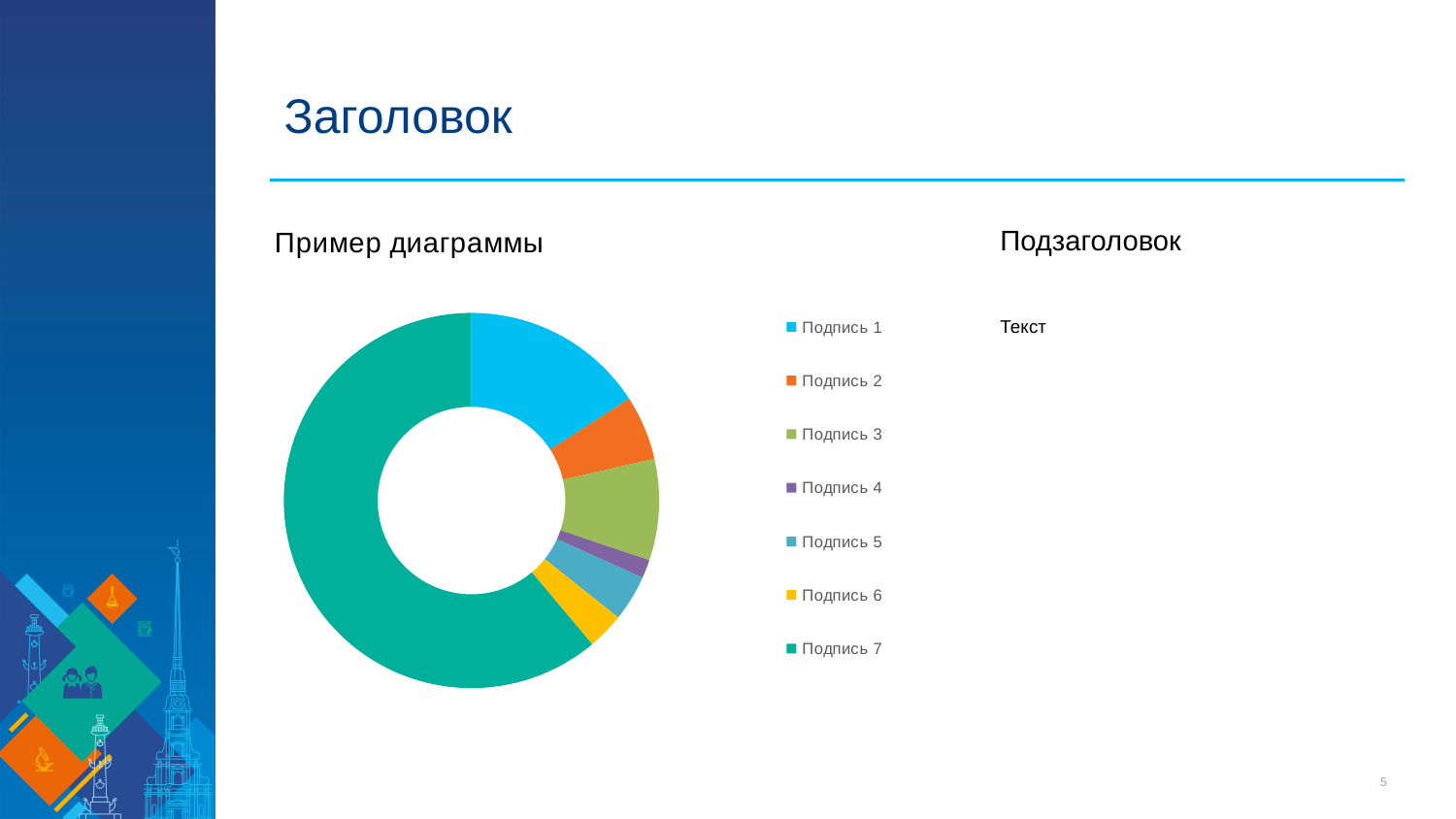
Which category has the smallest slice in the chart? Подпись 4 What colour is the slice for Подпись 6 in the chart? Yellow Which slice is larger, Подпись 7 or Подпись 3? Подпись 7 How many categories does the legend of the chart list? 7 Which slice is larger, Подпись 1 or Подпись 2? Подпись 1 Which category has the largest slice in the chart? Подпись 7 Which slice is larger, Подпись 3 or Подпись 6? Подпись 3 What kind of chart is shown on the slide? Doughnut (pie) chart What is the title shown above the chart? Пример диаграммы